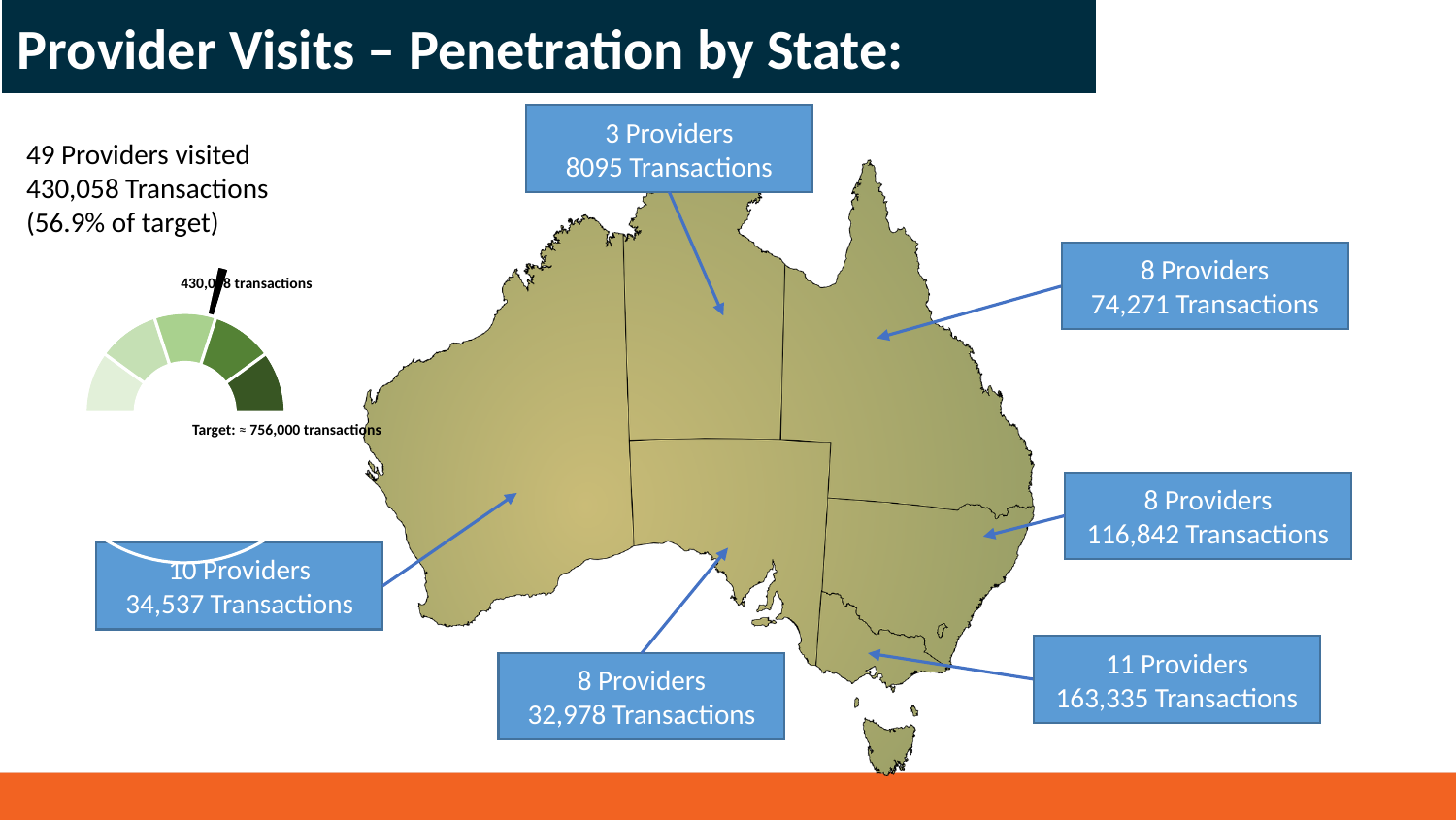
On the gauge chart, is the transactions value shown by the needle greater or less than the stated target? less On the gauge chart, what target is stated below the gauge? ≈ 756,000 transactions What kind of chart is shown on the left of the slide, below the '49 Providers visited' text? gauge chart On the map of Australia, what is the difference in transactions between the callout showing 116,842 Transactions and the callout showing 74,271 Transactions? 42,571 On the map of Australia, which callout shows the highest number of transactions? 11 Providers, 163,335 Transactions On the gauge chart, what value does the needle label show? 430,058 transactions What colour family are the segments of the gauge chart? shades of green On the map of Australia, how many callout boxes with provider and transaction figures are shown? 6 On the map of Australia, which has more transactions: the callout with 10 Providers or the callout with 8 Providers and 32,978 Transactions? the callout with 10 Providers How many coloured segments make up the gauge chart? 5 On the map of Australia, which callout shows the lowest number of transactions? 3 Providers, 8095 Transactions On the map of Australia, how many transactions are shown in the callout with 10 Providers? 34,537 Transactions